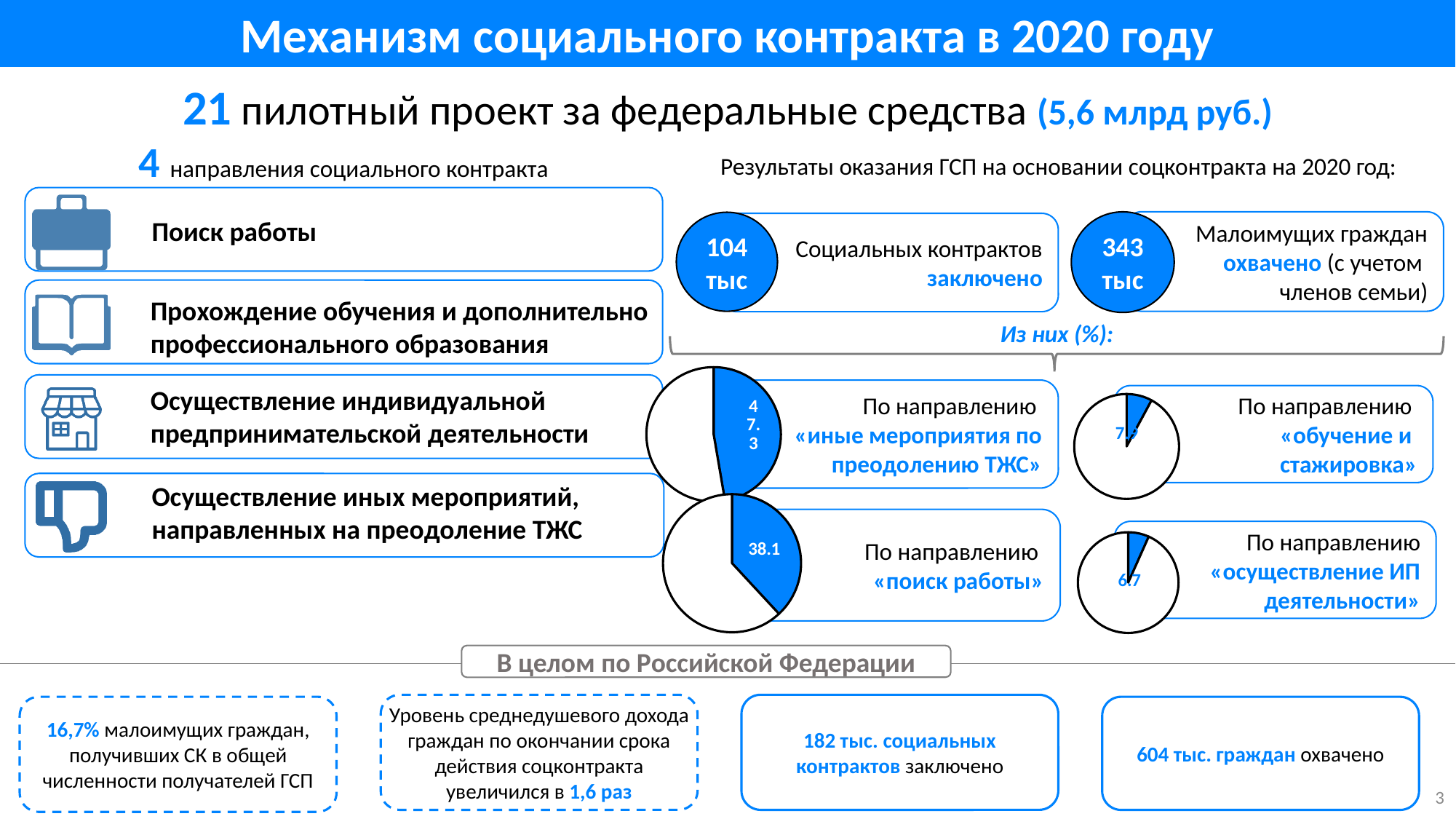
How many pie charts are shown on the slide? 4 Which share is larger: «поиск работы» or «обучение и стажировка»? «поиск работы» What is the difference between the share for «поиск работы» and the share for «осуществление ИП деятельности»? 31.4 Which direction has the smallest share among the four pie charts? «осуществление ИП деятельности» What kind of charts are used to show the shares by direction ("Из них (%)") on the slide? pie charts In the pie chart for the direction «иные мероприятия по преодолению ТЖС», what percentage is shown? 47.3 What is the difference between the share for «иные мероприятия по преодолению ТЖС» and the share for «поиск работы»? 9.2 What heading is placed above the four pie charts? Из них (%): What colour is the highlighted slice in each of the pie charts? blue In the pie chart for the direction «осуществление ИП деятельности», what percentage is shown? 6.7 In the pie chart for the direction «поиск работы», what percentage is shown? 38.1 Which direction has the largest share among the four pie charts? «иные мероприятия по преодолению ТЖС»